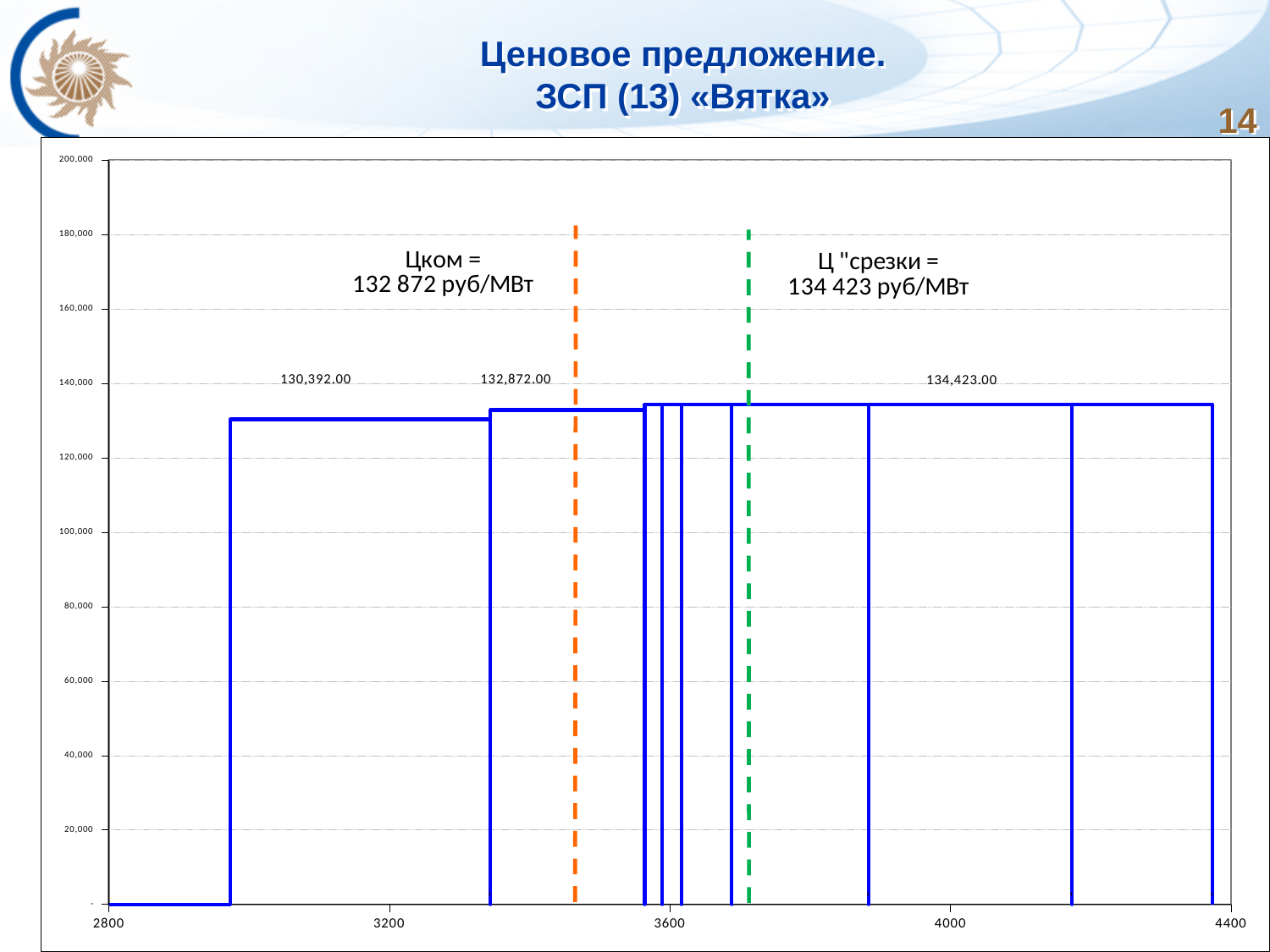
What value of Цком is stated in the annotation on the chart? 132 872 руб/МВт Which of the three labelled price levels is the lowest? 130,392.00 What value of Ц "срезки" is stated in the annotation on the chart? 134 423 руб/МВт What is the value of the data label shown above the second step of the price curve? 132,872.00 What is the value of the data label shown above the rightmost step of the price curve? 134,423.00 What is the value of the data label shown above the first (leftmost) step of the price curve? 130,392.00 What is the difference between the labelled values 132,872.00 and 130,392.00? 2,480.00 Which of the three labelled price levels is the highest? 134,423.00 Do the labelled price levels rise or fall as you move from left to right along the x axis? rise Is the price level of the leftmost step (130,392.00) greater or less than 140,000 on the y axis? less What is the difference between the labelled values 134,423.00 and 132,872.00? 1,551.00 How many price values are printed as data labels on the chart? 3